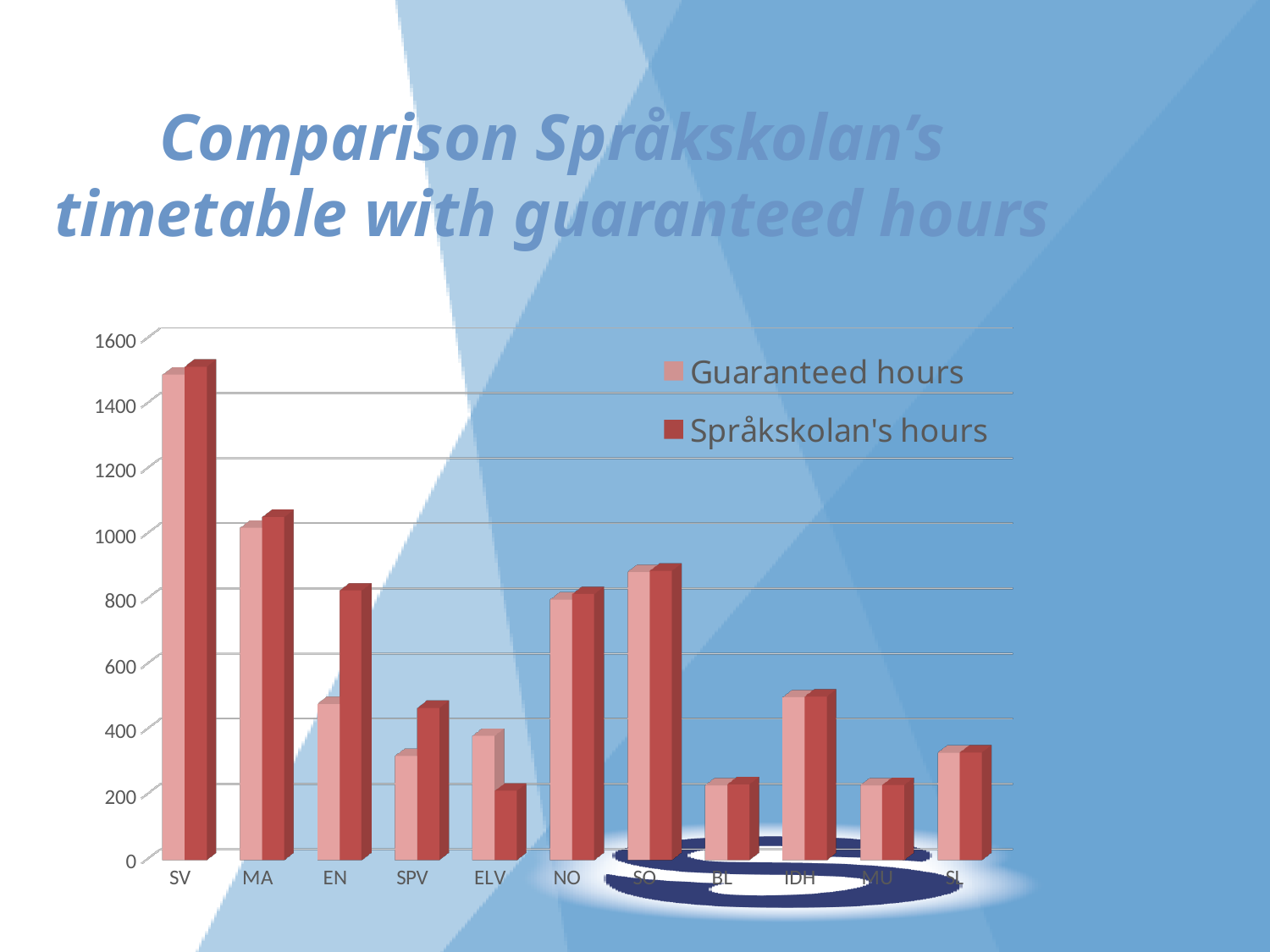
Which category has the highest value for Guaranteed hours? SV How many categories are shown on the x axis? 11 Is the Språkskolan's hours value for ELV greater or less than 400? less For EN, which is larger: Guaranteed hours or Språkskolan's hours? Språkskolan's hours For ELV, which is larger: Guaranteed hours or Språkskolan's hours? Guaranteed hours Which colour represents Språkskolan's hours in the legend? Dark red Is the Guaranteed hours value for SPV greater or less than 400? less Which category has the highest value for Språkskolan's hours? SV What kind of chart is shown on the slide? Bar chart How many series does the legend list? 2 Is the Guaranteed hours value for SV greater or less than 1400? greater